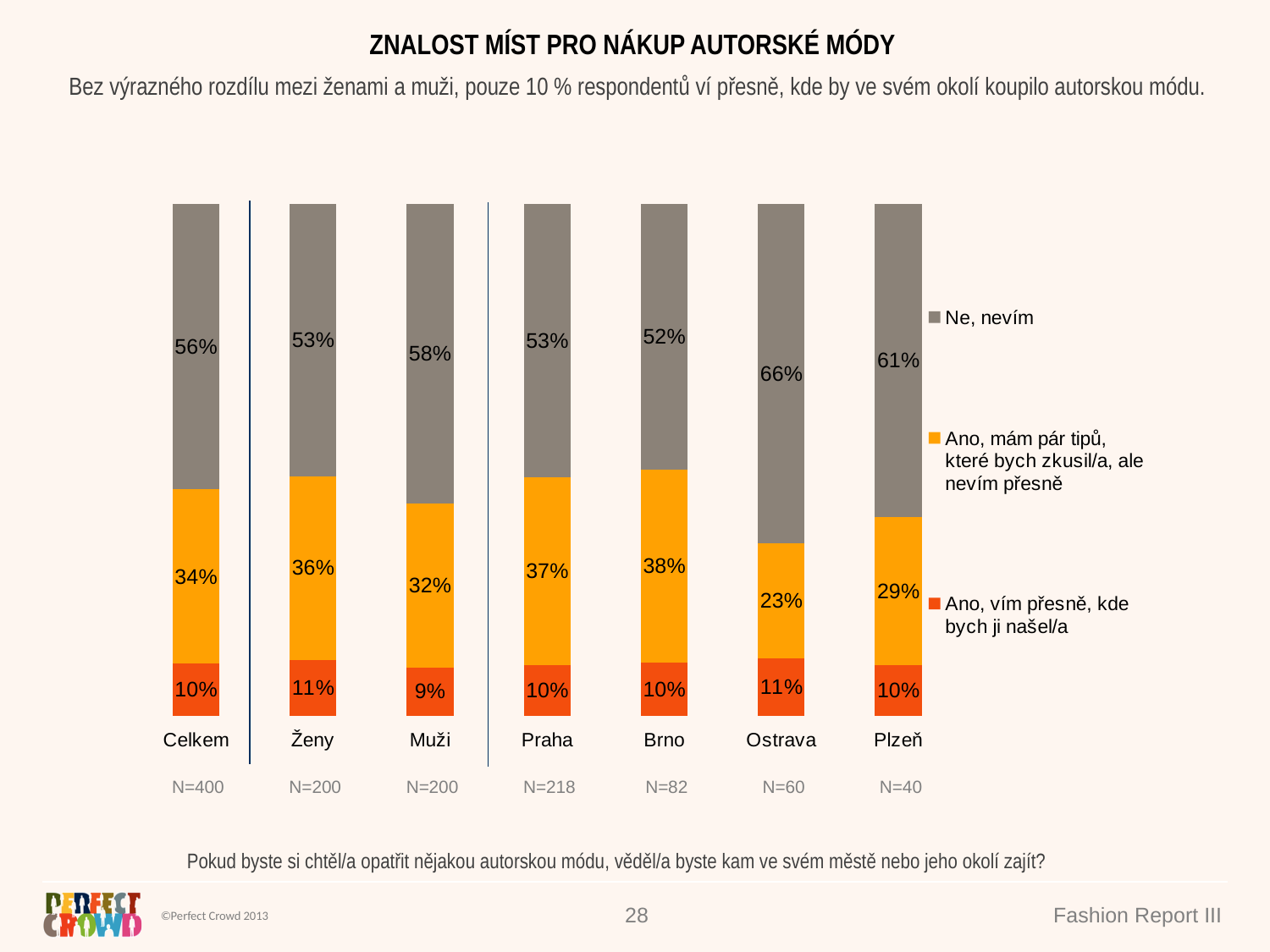
What is the sample size (N) shown for the Praha category? N=218 What percentage of respondents in Ostrava answered "Ne, nevím"? 66% Which colour represents the "Ne, nevím" series in the chart? Grey How many series does the legend list? 3 Which category has the lowest value for "Ano, mám pár tipů, které bych zkusil/a, ale nevím přesně"? Ostrava What is the value for "Ano, vím přesně, kde bych ji našel/a" in the Muži category? 9% What share of respondents in Brno answered "Ano, mám pár tipů, které bych zkusil/a, ale nevím přesně"? 38% Which category has the highest value for "Ne, nevím"? Ostrava What kind of chart is shown on the slide? Stacked bar chart What is the difference between the "Ne, nevím" values for Plzeň and Celkem? 5% How many categories are shown on the x axis of the chart? 7 Which is larger: the "Ano, mám pár tipů" value for Ženy or for Muži? Ženy